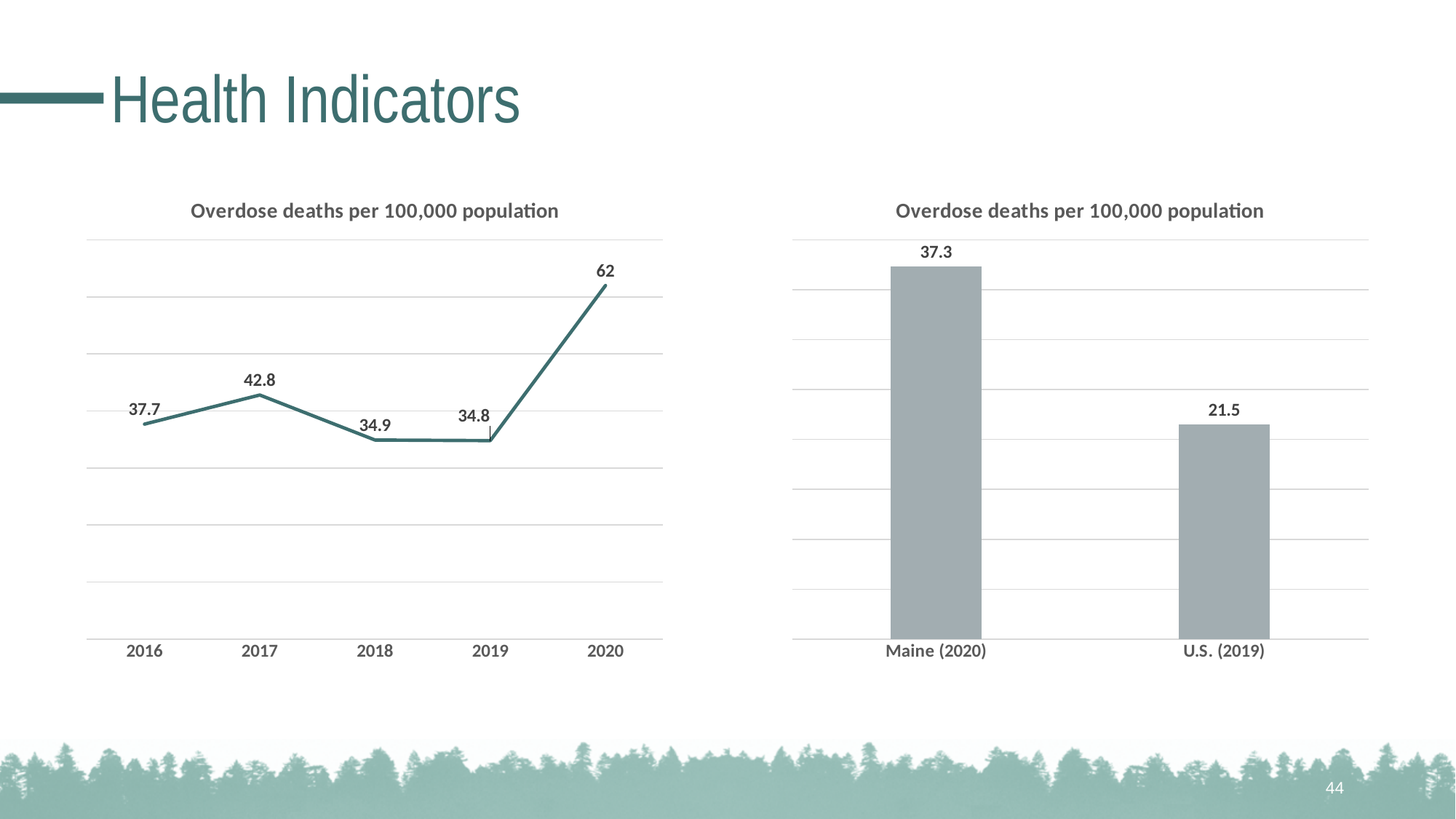
In the left chart (line chart), what is the difference between the 2020 value and the 2019 value? 27.2 In the right chart (bar chart), what is the value for Maine (2020)? 37.3 In the right chart (bar chart), what is the difference between Maine (2020) and U.S. (2019)? 15.8 In the left chart (line chart), what is the value for 2017? 42.8 In the left chart (line chart), what is the value for 2020? 62 In the right chart (bar chart), which is larger, Maine (2020) or U.S. (2019)? Maine (2020) In the left chart (line chart), does the value rise or fall from 2019 to 2020? rise What type of chart is the right chart? bar chart In the left chart (line chart), which year has the lowest value? 2019 In the left chart (line chart), which year has the highest value? 2020 In the left chart (line chart), how many years are plotted? 5 In the right chart (bar chart), what is the value for U.S. (2019)? 21.5